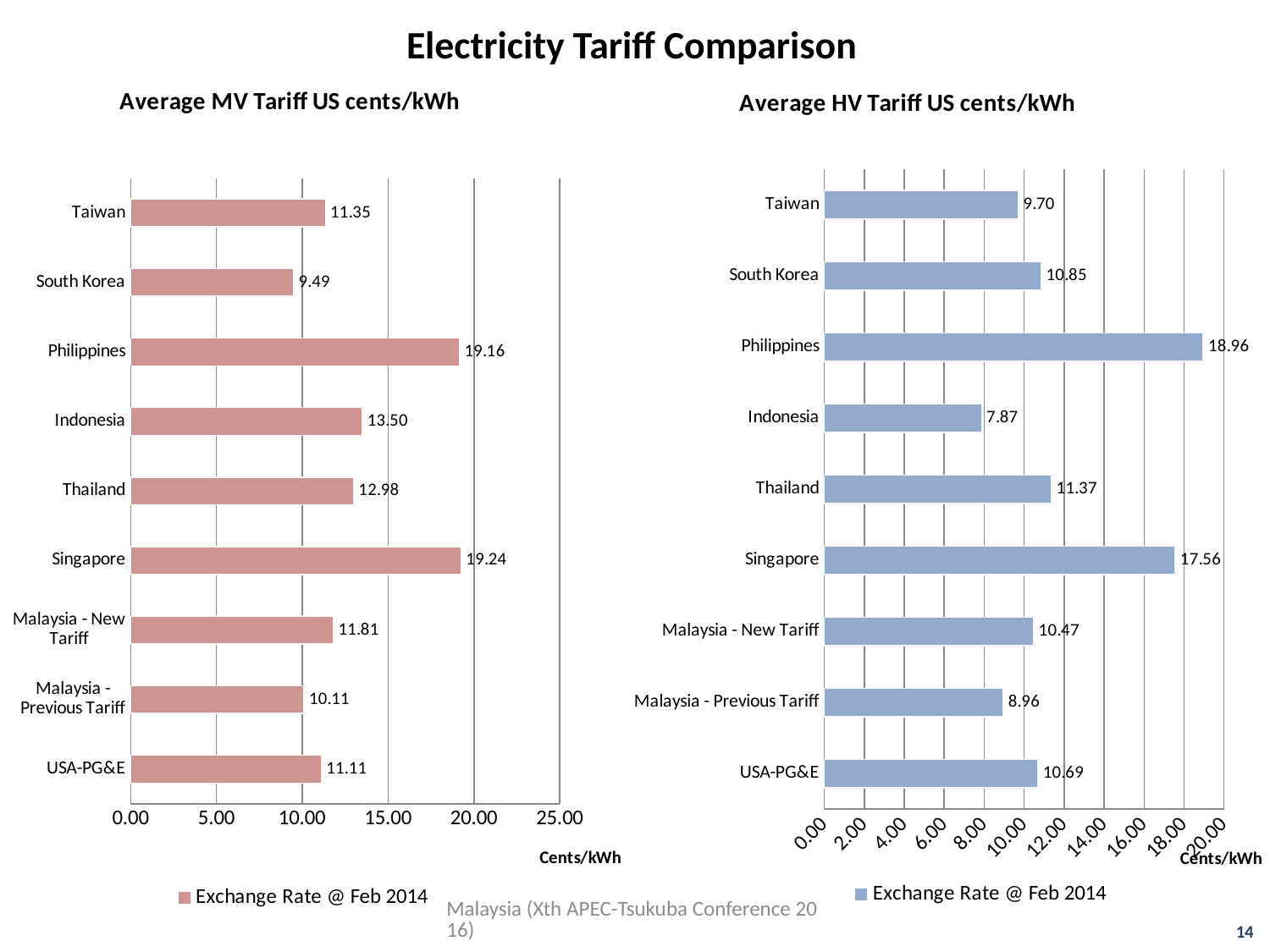
In the Average MV Tariff US cents/kWh chart, what is the difference between Malaysia - New Tariff and Malaysia - Previous Tariff? 1.70 What is the legend entry shown under the Average HV Tariff US cents/kWh chart? Exchange Rate @ Feb 2014 How many series does the legend of the Average MV Tariff US cents/kWh chart list? 1 In the Average MV Tariff US cents/kWh chart, which category has the lowest value? South Korea In the Average MV Tariff US cents/kWh chart, what is the value for Philippines? 19.16 How many categories are shown in the Average MV Tariff US cents/kWh chart? 9 In the Average HV Tariff US cents/kWh chart, which category has the lowest value? Indonesia In the Average HV Tariff US cents/kWh chart, what is the value for Indonesia? 7.87 In the Average HV Tariff US cents/kWh chart, which category has the highest value? Philippines In the Average MV Tariff US cents/kWh chart, which category has the highest value? Singapore What kind of chart is the Average HV Tariff US cents/kWh chart? Bar chart In the Average HV Tariff US cents/kWh chart, which is larger, the value for Thailand or the value for South Korea? Thailand